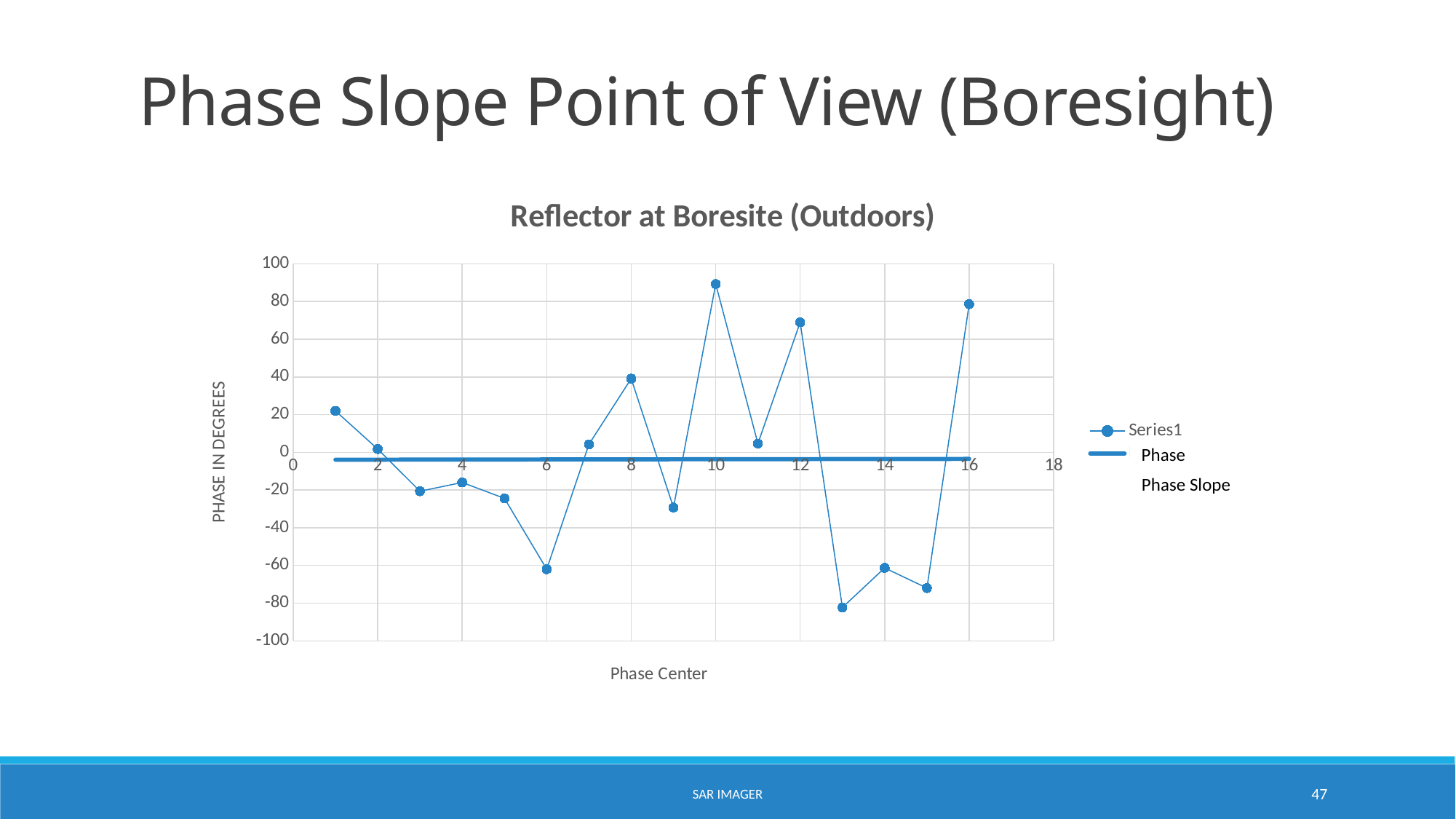
At which Phase Center does Series1 reach its highest value? 10 Is the Series1 value at Phase Center 10 greater or less than 80? greater Which has the larger Series1 value, Phase Center 10 or Phase Center 12? Phase Center 10 How many data points are plotted for Series1? 16 What is the label of the vertical axis? PHASE IN DEGREES What is the title of the chart? Reflector at Boresite (Outdoors) How many entries does the chart legend list? 3 What kind of chart is shown on the slide? line chart Do the Series1 values rise or fall from Phase Center 2 to Phase Center 6? fall At which Phase Center does Series1 reach its lowest value? 13 Is the Series1 value at Phase Center 16 greater or less than 60? greater